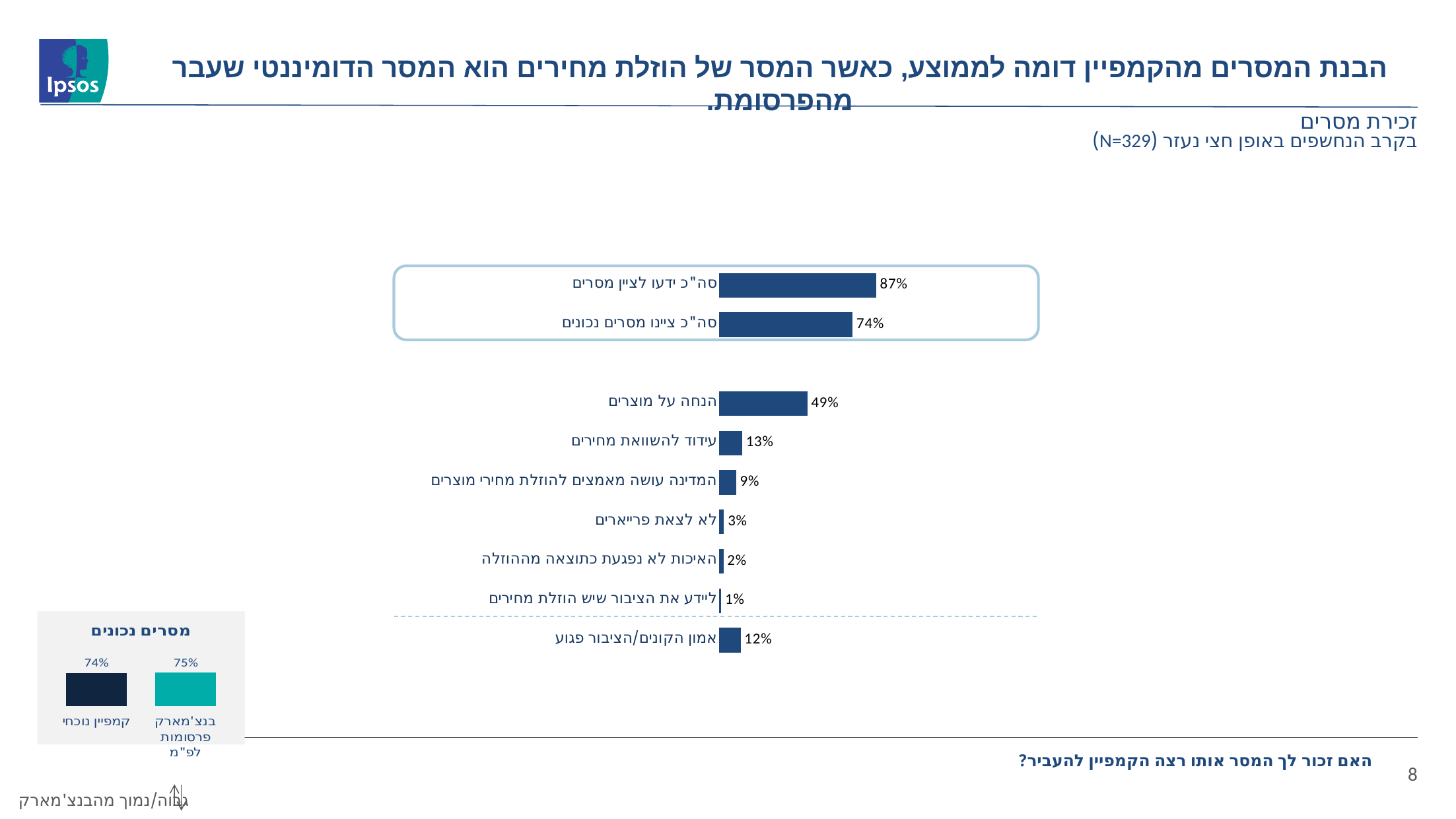
How many bars are shown in the main bar chart? 9 In the main bar chart, which category has the highest value? סה"כ ידעו לציין מסרים In the main bar chart, which category has the lowest value? ליידע את הציבור שיש הוזלת מחירים In the main bar chart, which is larger: "עידוד להשוואת מחירים" or "המדינה עושה מאמצים להוזלת מחירי מוצרים"? עידוד להשוואת מחירים In the small "מסרים נכונים" chart at the bottom left, what is the difference between "בנצ'מארק פרסומות לפ"מ" and "קמפיין נוכחי"? 1% In the main bar chart, what is the value for "אמון הקונים/הציבור פגוע"? 12% In the main bar chart, what is the value for "הנחה על מוצרים"? 49% In the main bar chart, what is the value for "סה"כ ידעו לציין מסרים"? 87% In the small "מסרים נכונים" chart at the bottom left, what is the value for "קמפיין נוכחי"? 74% In the main bar chart, what is the value for "עידוד להשוואת מחירים"? 13% What type of chart is the main chart on the slide? Bar chart In the main bar chart, what is the difference between "סה"כ ידעו לציין מסרים" and "סה"כ ציינו מסרים נכונים"? 13%